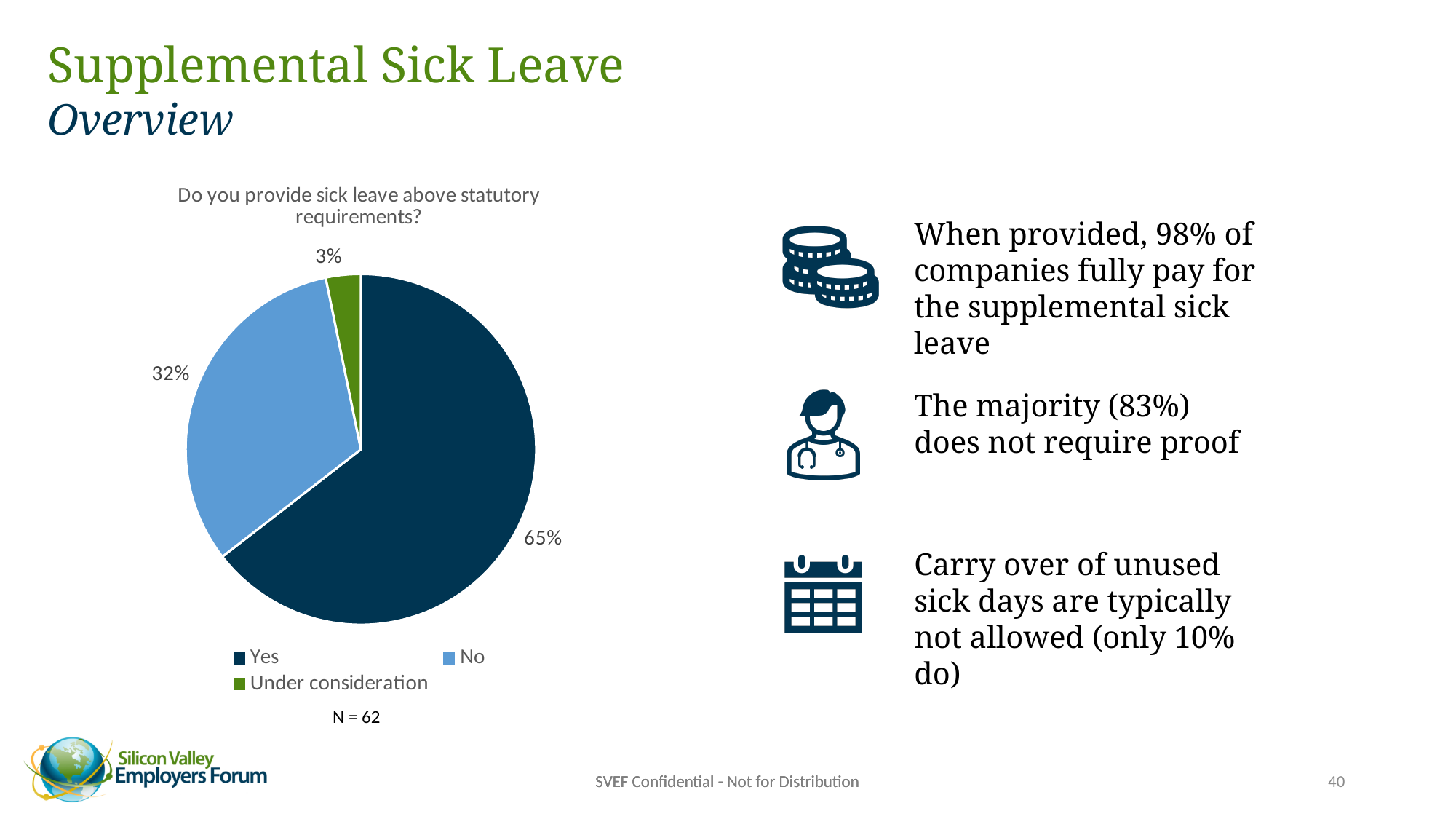
How many entries does the legend list? 3 What is the chart's title? Do you provide sick leave above statutory requirements? Which response has the largest share of the pie? Yes What type of chart is shown on the slide? pie chart Which is larger, the "No" slice or the "Under consideration" slice? No What percentage of respondents answered "No"? 32% What is the difference in percentage points between the "Yes" and "No" slices? 33 What is the sample size (N) shown below the chart? N = 62 What percentage of respondents answered "Under consideration"? 3% What percentage of respondents answered "Yes"? 65% How many slices does the pie chart have? 3 Which response has the smallest share of the pie? Under consideration